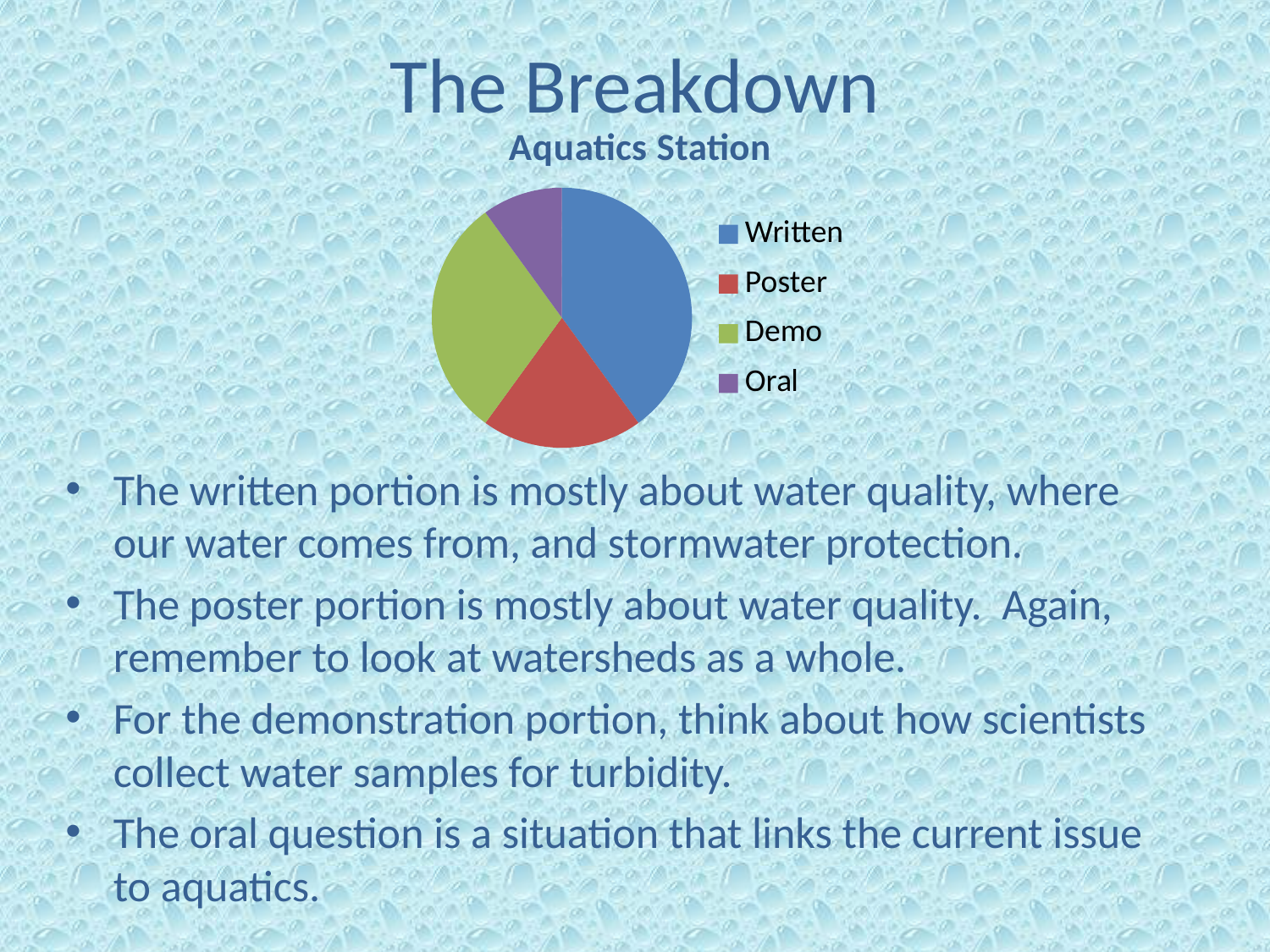
Which category has the largest slice of the pie? Written What kind of chart is shown on the slide? pie chart How many entries does the chart legend list? 4 Which slice is larger, Written or Demo? Written Which slice is larger, Poster or Oral? Poster Which slice is larger, Demo or Poster? Demo What colour is the Demo slice in the pie chart? green How many slices does the pie chart have? 4 What is the title of the chart? Aquatics Station Which category has the smallest slice of the pie? Oral